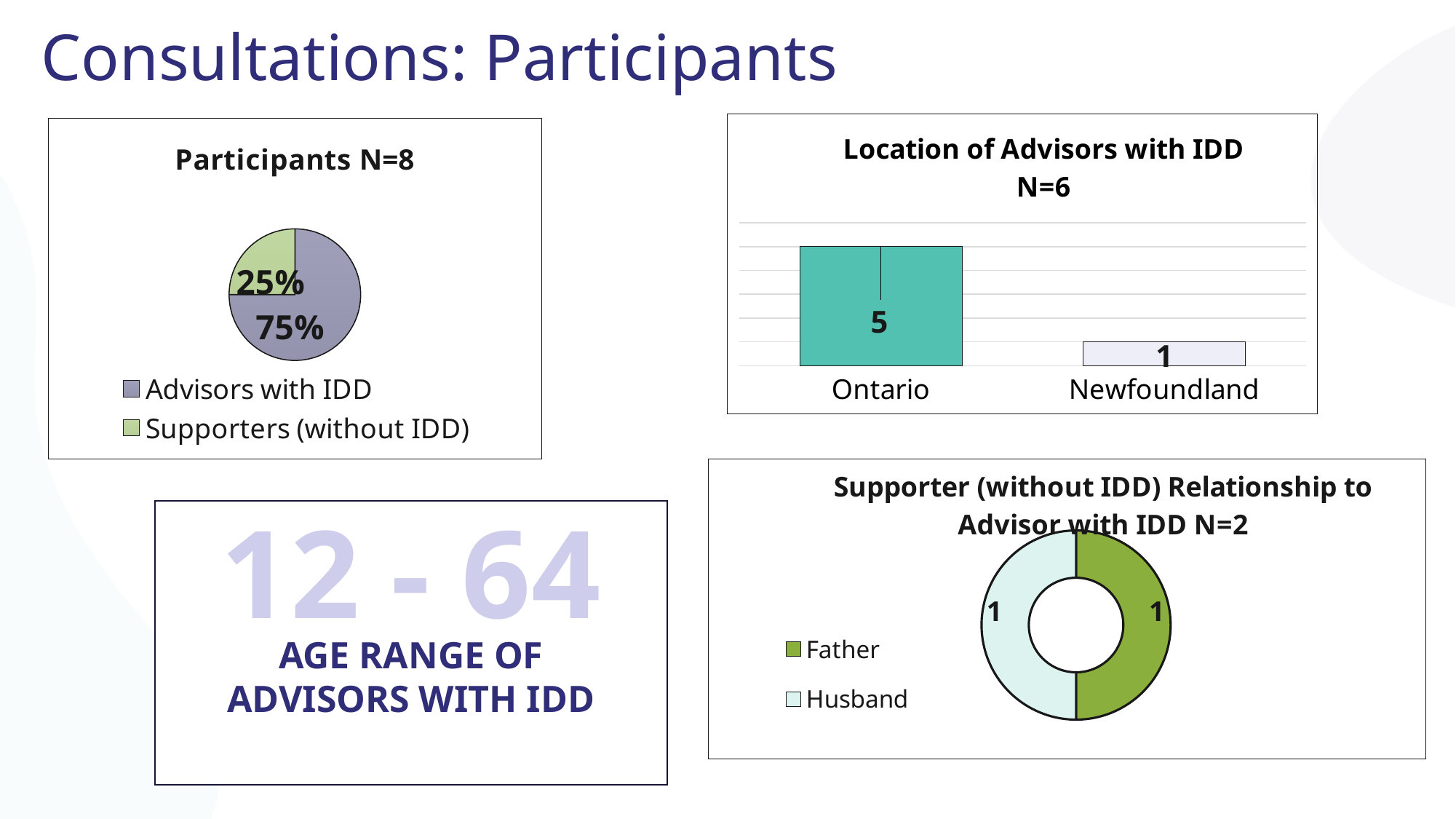
What kind of chart is the 'Participants N=8' chart? Pie chart In the 'Location of Advisors with IDD N=6' chart, what is the value for Ontario? 5 In the 'Participants N=8' chart, what share of participants are Advisors with IDD? 75% In the 'Participants N=8' chart, which group has the larger share? Advisors with IDD In the 'Location of Advisors with IDD N=6' chart, what is the difference between Ontario and Newfoundland? 4 In the 'Location of Advisors with IDD N=6' chart, which location has the lowest value? Newfoundland How many categories are shown in the 'Location of Advisors with IDD N=6' chart? 2 In the 'Supporter (without IDD) Relationship to Advisor with IDD N=2' chart, what is the value for Father? 1 In the 'Participants N=8' chart, what share of participants are Supporters (without IDD)? 25% What kind of chart is the 'Location of Advisors with IDD N=6' chart? Bar chart How many entries does the legend of the 'Supporter (without IDD) Relationship to Advisor with IDD N=2' chart list? 2 In the 'Location of Advisors with IDD N=6' chart, what is the value for Newfoundland? 1